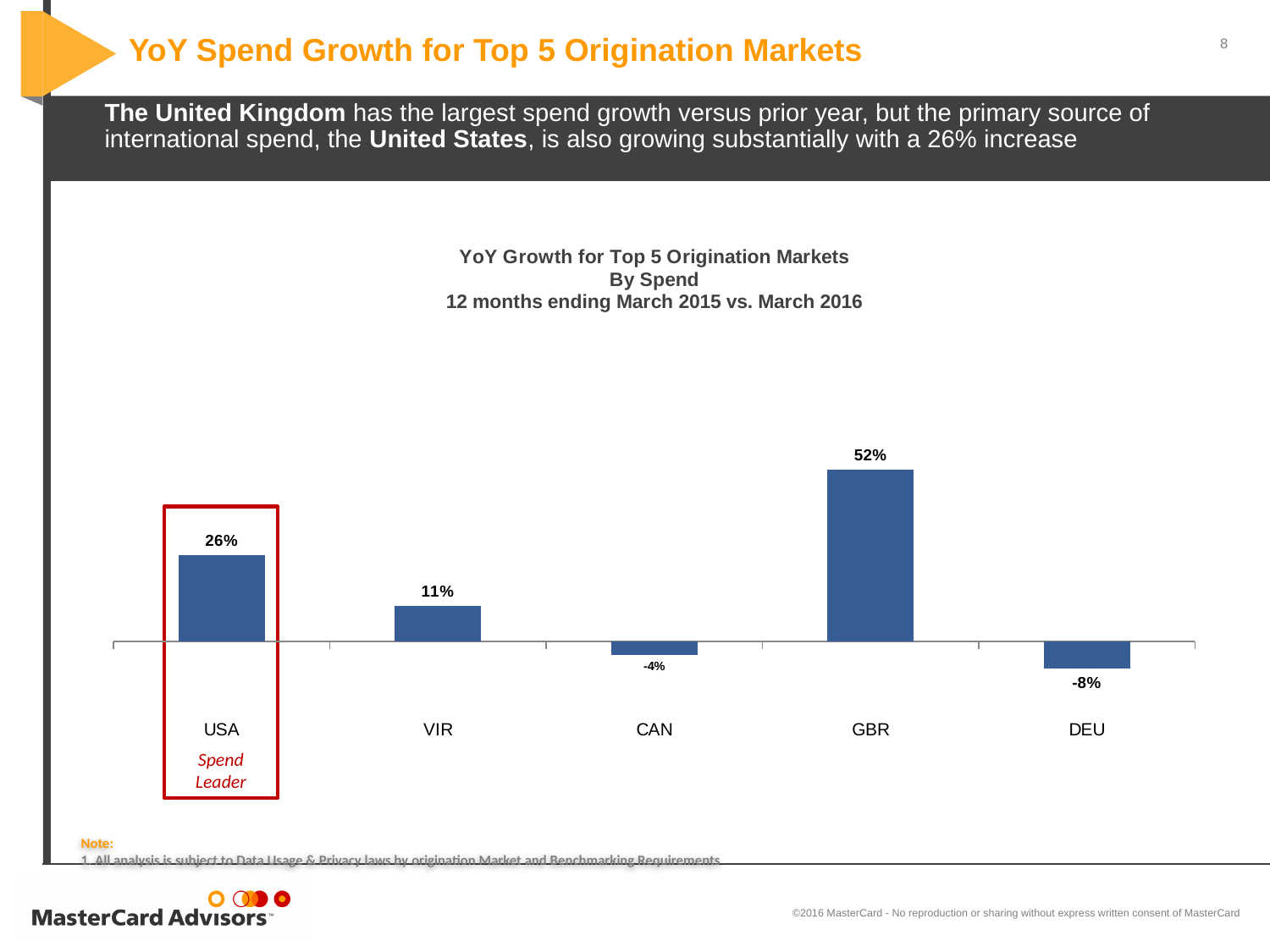
What type of chart is shown on the slide? Bar chart What is the YoY spend growth for GBR? 52% What is the difference in YoY spend growth between GBR and USA? 26 percentage points How many origination markets are shown in the chart? 5 Which market is labelled as the Spend Leader in the chart? USA Which origination market has the highest YoY spend growth? GBR What is the YoY spend growth for USA? 26% What is the YoY spend growth for CAN? -4% Which has higher YoY spend growth, VIR or USA? USA What period does the chart compare? 12 months ending March 2015 vs. March 2016 Which origination market has the lowest YoY spend growth? DEU What is the YoY spend growth for DEU? -8%